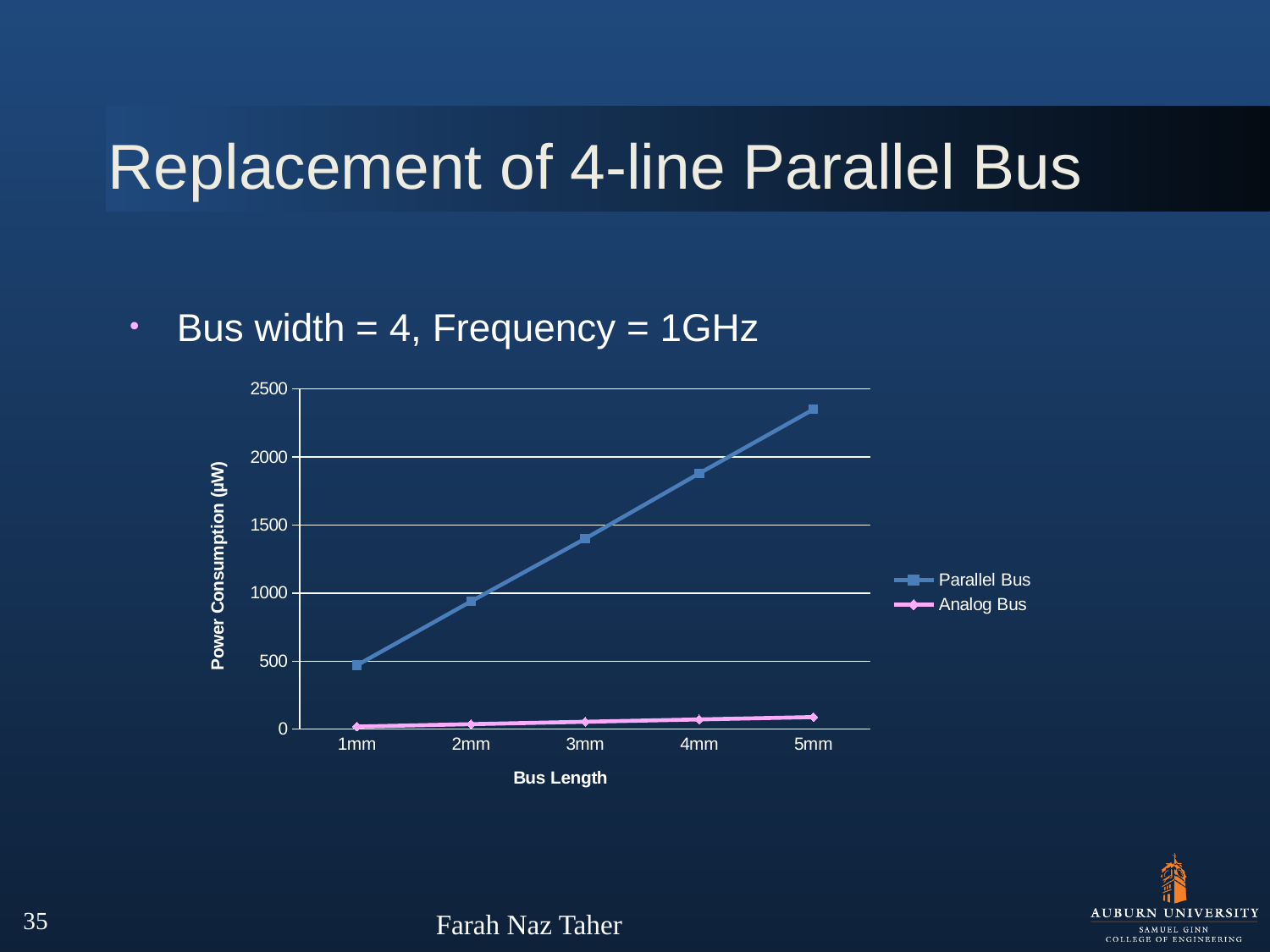
What kind of chart is shown on the slide? line chart Is the Analog Bus value at 5mm greater or less than 500? less What is the title of the y axis? Power Consumption (µW) At 3mm, which series has the larger power consumption, Parallel Bus or Analog Bus? Parallel Bus Is the Parallel Bus value at 3mm greater or less than 1000? greater How many bus length categories are plotted on the x axis? 5 Is the Parallel Bus value at 5mm greater or less than 2000? greater At which bus length is the Parallel Bus power consumption lowest? 1mm At which bus length is the Parallel Bus power consumption highest? 5mm How many series does the legend list? 2 Does the Parallel Bus power consumption rise or fall as bus length increases from 1mm to 5mm? rise